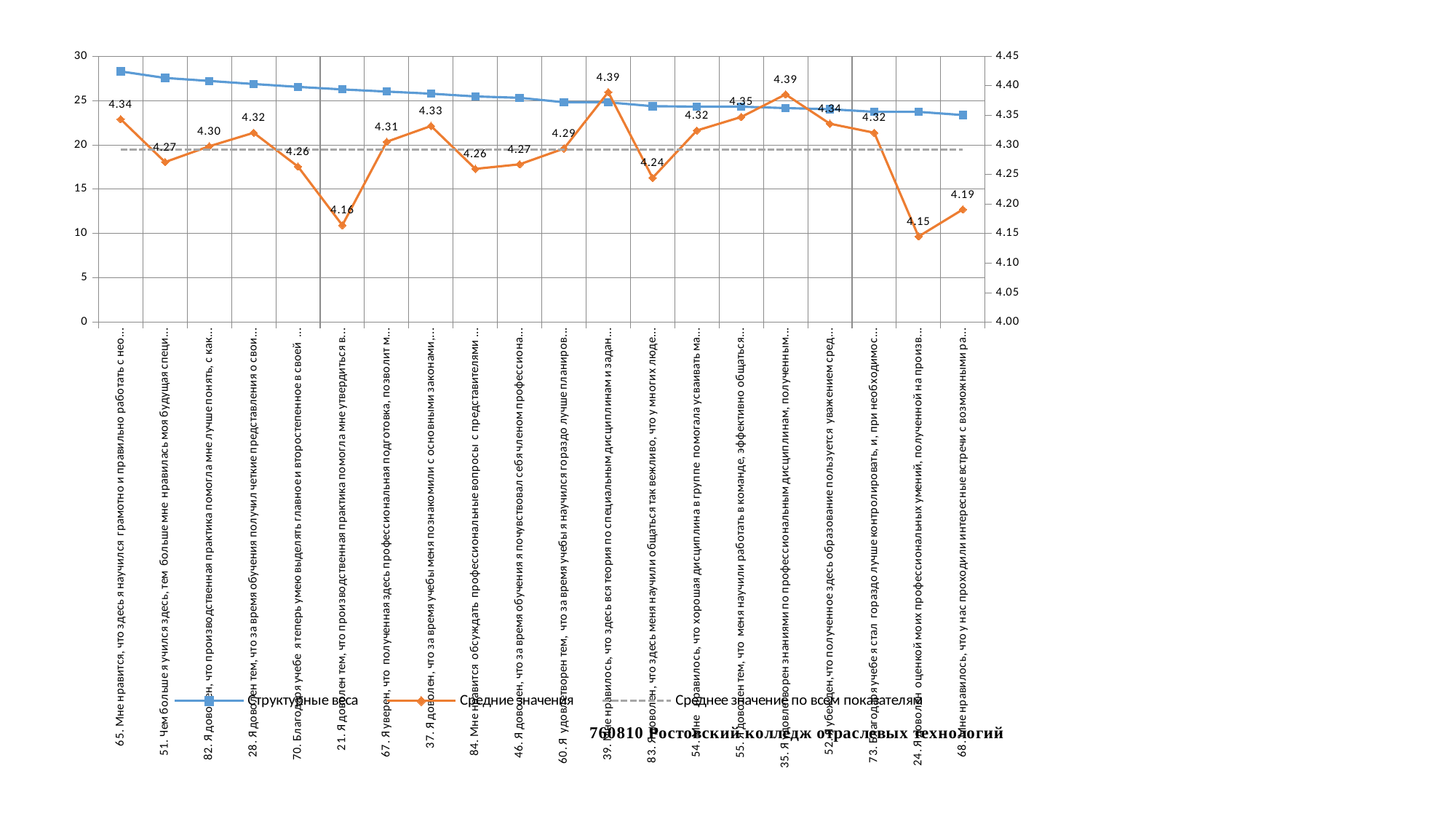
Do the values of "Структурные веса" rise or fall from left to right along the x axis? fall What is the value of "Средние значения" for item 65 ("Мне нравится, что здесь я научился грамотно и правильно работать...")? 4.34 What is the value of "Средние значения" for item 39 ("Мне нравилось, что здесь вся теория по специальным дисциплинам...")? 4.39 Which has a larger "Средние значения" value: item 55 ("Я доволен тем, что меня научили работать в команде...") or item 83 ("Я доволен, что здесь меня научили общаться так вежливо...")? item 55 What is the difference between the highest "Средние значения" value (4.39) and the lowest (4.15)? 0.24 What is the legend entry for the dashed grey line? Среднее значение по всем показателям What kind of chart is shown on the slide? line chart Is the "Структурные веса" value for the first item (65) greater or less than 25 on the left axis? greater How many categories are plotted along the x axis? 20 Which item has the lowest value of "Средние значения"? 24. Я доволен оценкой моих профессиональных умений, полученной на произв... How many series does the legend list? 3 What is the value of "Средние значения" for item 21 ("Я доволен тем, что производственная практика помогла мне утвердиться...")? 4.16